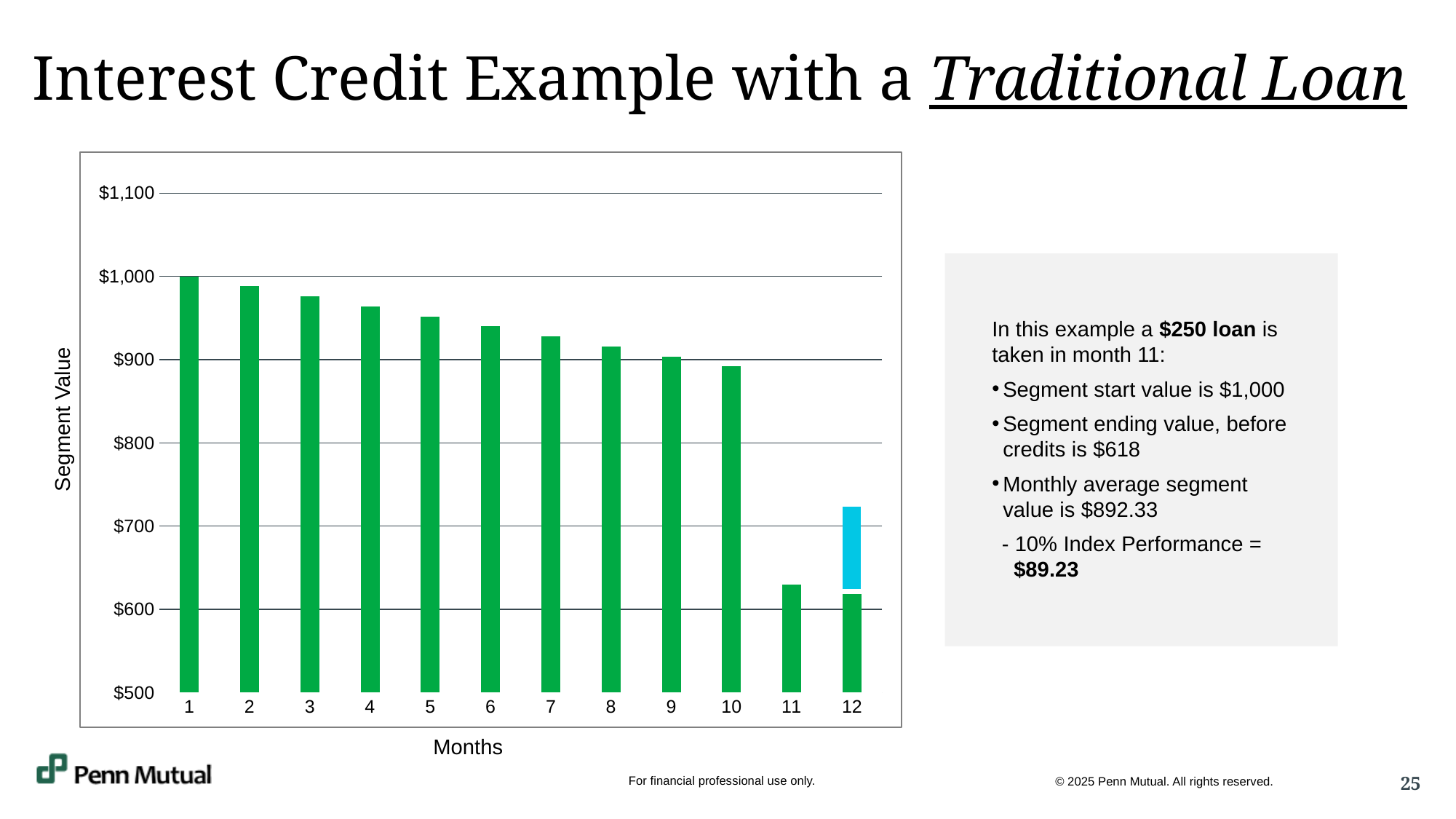
Which month's bar includes a light blue segment on top? 12 Which has a larger segment value, month 2 or month 8? month 2 What is the segment value for month 1? $1,000 Is the segment value for month 11 greater or less than $700? less Which has a larger segment value, month 3 or month 11? month 3 What kind of chart is shown on the slide? bar chart Is the total height of the month 12 bar greater or less than $800? less Do the segment values rise or fall from month 1 to month 10? fall Which month has the highest segment value in the chart? 1 Is the segment value for month 5 greater or less than $900? greater What is the title of the y axis of the chart? Segment Value How many months are plotted on the x axis of the chart? 12